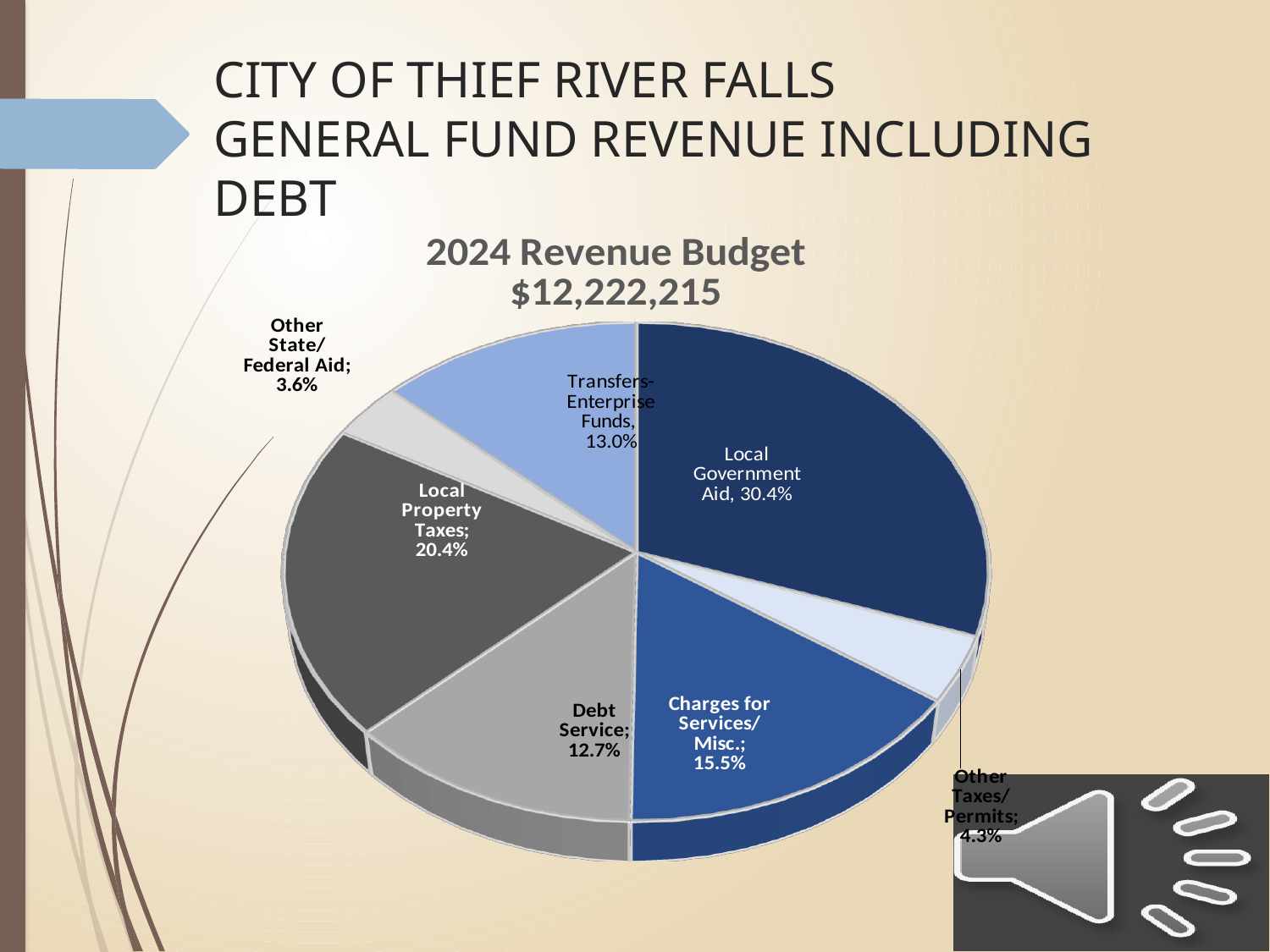
What is the title of the chart? 2024 Revenue Budget $12,222,215 What percentage is shown for Transfers-Enterprise Funds? 13.0% What share of the 2024 Revenue Budget is Local Government Aid? 30.4% Which is larger, Debt Service or Transfers-Enterprise Funds? Transfers-Enterprise Funds What share of the budget is Other State/Federal Aid? 3.6% Which category has the smallest share of the pie? Other State/Federal Aid What is the difference in percentage points between Local Government Aid and Local Property Taxes? 10.0 What kind of chart is shown on the slide? Pie chart What percentage of the pie is Local Property Taxes? 20.4% How many slices does the pie chart have? 7 What share does Charges for Services/Misc. represent? 15.5% Which category has the largest share of the 2024 Revenue Budget? Local Government Aid